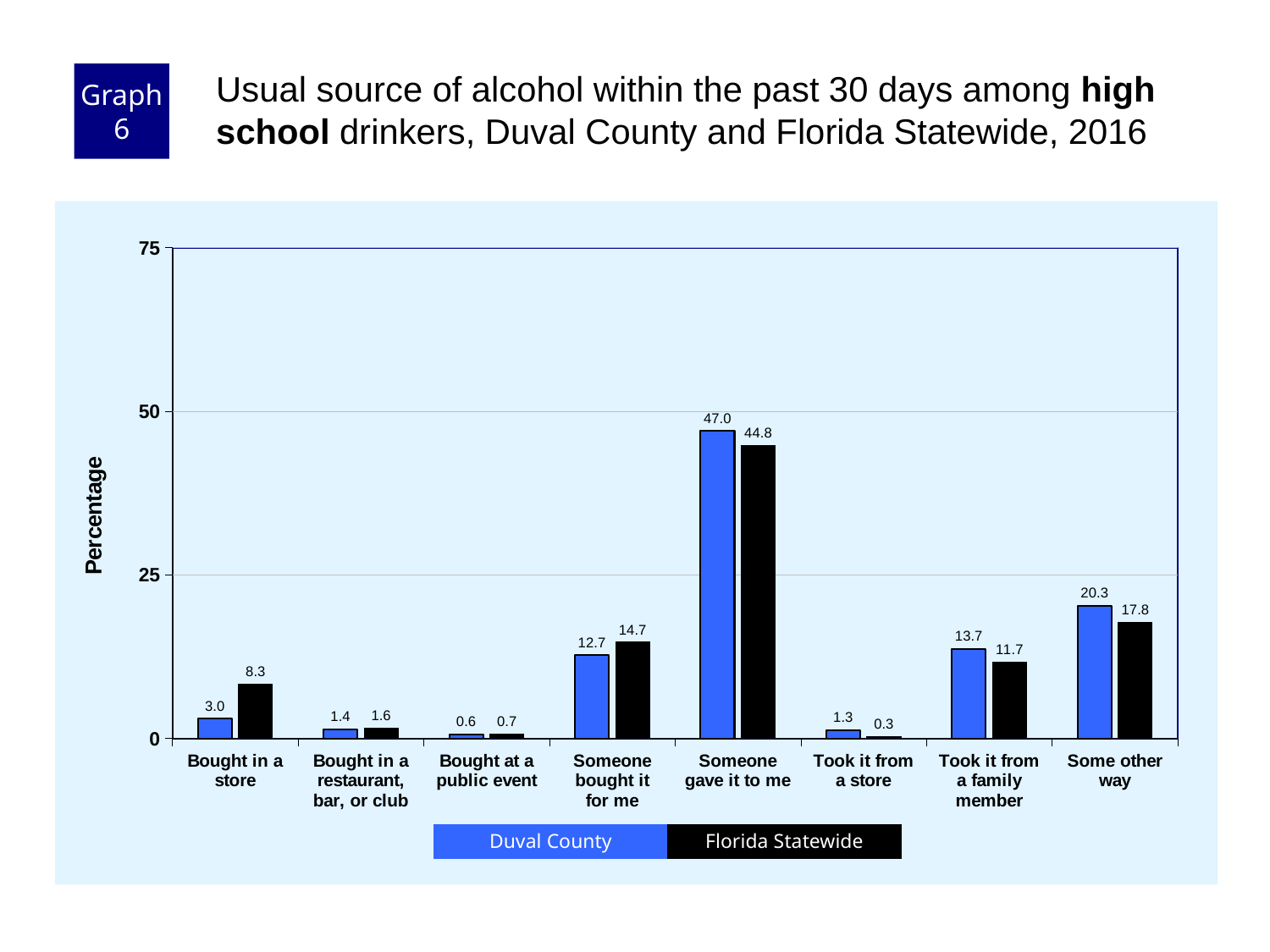
What is the Duval County value for "Took it from a family member"? 13.7 What is the difference between the Duval County and Florida Statewide values for "Someone gave it to me"? 2.2 Is the Duval County value for "Some other way" greater or less than 25? less Which category has the highest Florida Statewide value? Someone gave it to me How many series does the legend list? 2 What is the Duval County value for "Someone gave it to me"? 47.0 How many categories are shown on the x axis? 8 What is the Florida Statewide value for "Bought in a store"? 8.3 Which is larger for "Someone bought it for me": Duval County or Florida Statewide? Florida Statewide What is the label on the y axis? Percentage Which category has the lowest Duval County value? Bought at a public event What kind of chart is shown on the slide? bar chart